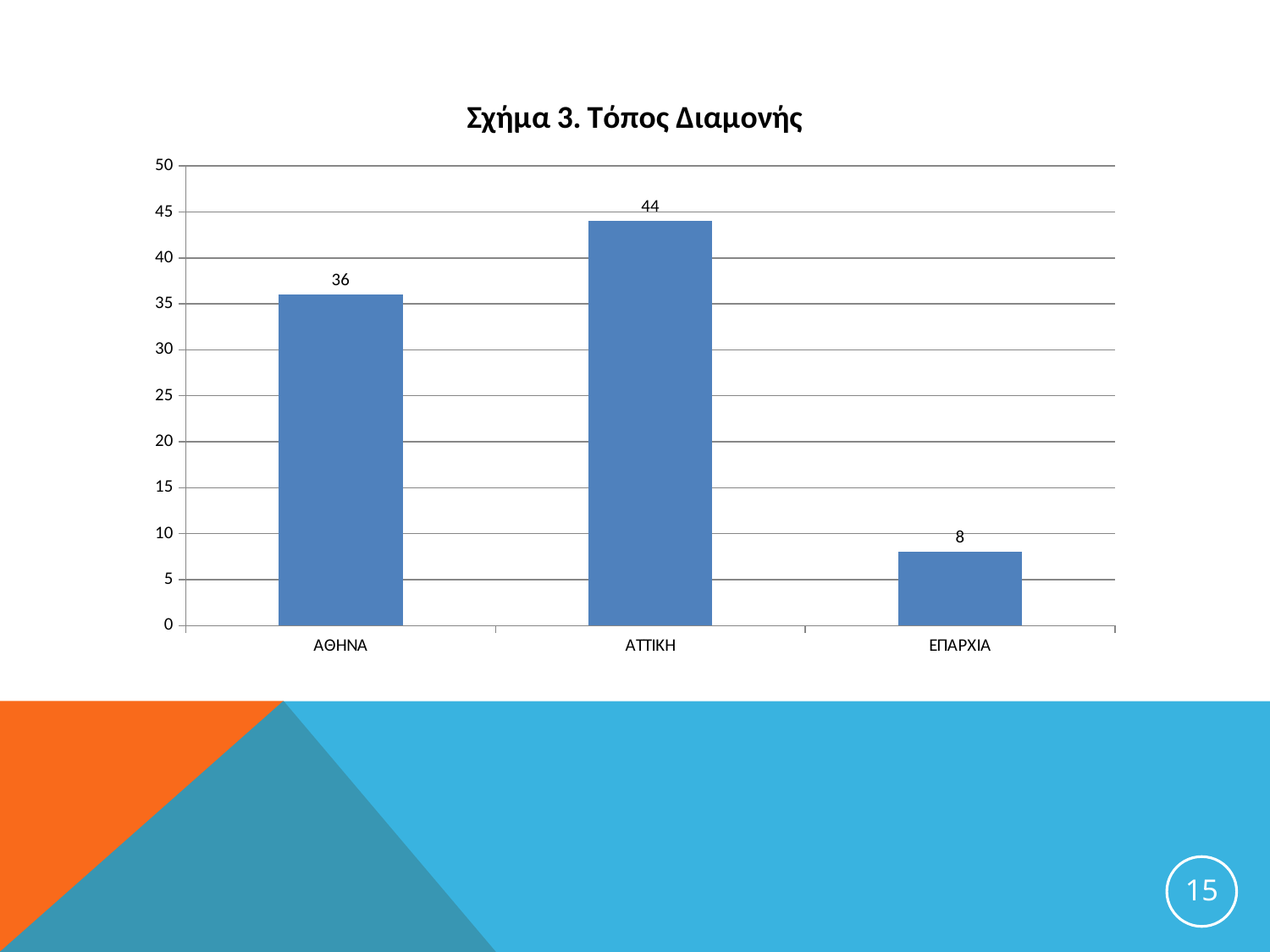
How many categories are shown on the x axis? 3 Is the value for ΑΤΤΙΚΗ greater or less than 40? greater What kind of chart is shown on the slide? bar chart Which category has the lowest value? ΕΠΑΡΧΙΑ Which category has the highest value? ΑΤΤΙΚΗ What is the title of the chart? Σχήμα 3. Τόπος Διαμονής What is the difference between the values for ΑΤΤΙΚΗ and ΑΘΗΝΑ? 8 What is the difference between the values for ΑΘΗΝΑ and ΕΠΑΡΧΙΑ? 28 Which is larger, the value for ΑΘΗΝΑ or the value for ΕΠΑΡΧΙΑ? ΑΘΗΝΑ What is the value for ΑΤΤΙΚΗ? 44 What is the value for ΑΘΗΝΑ? 36 What is the value for ΕΠΑΡΧΙΑ? 8